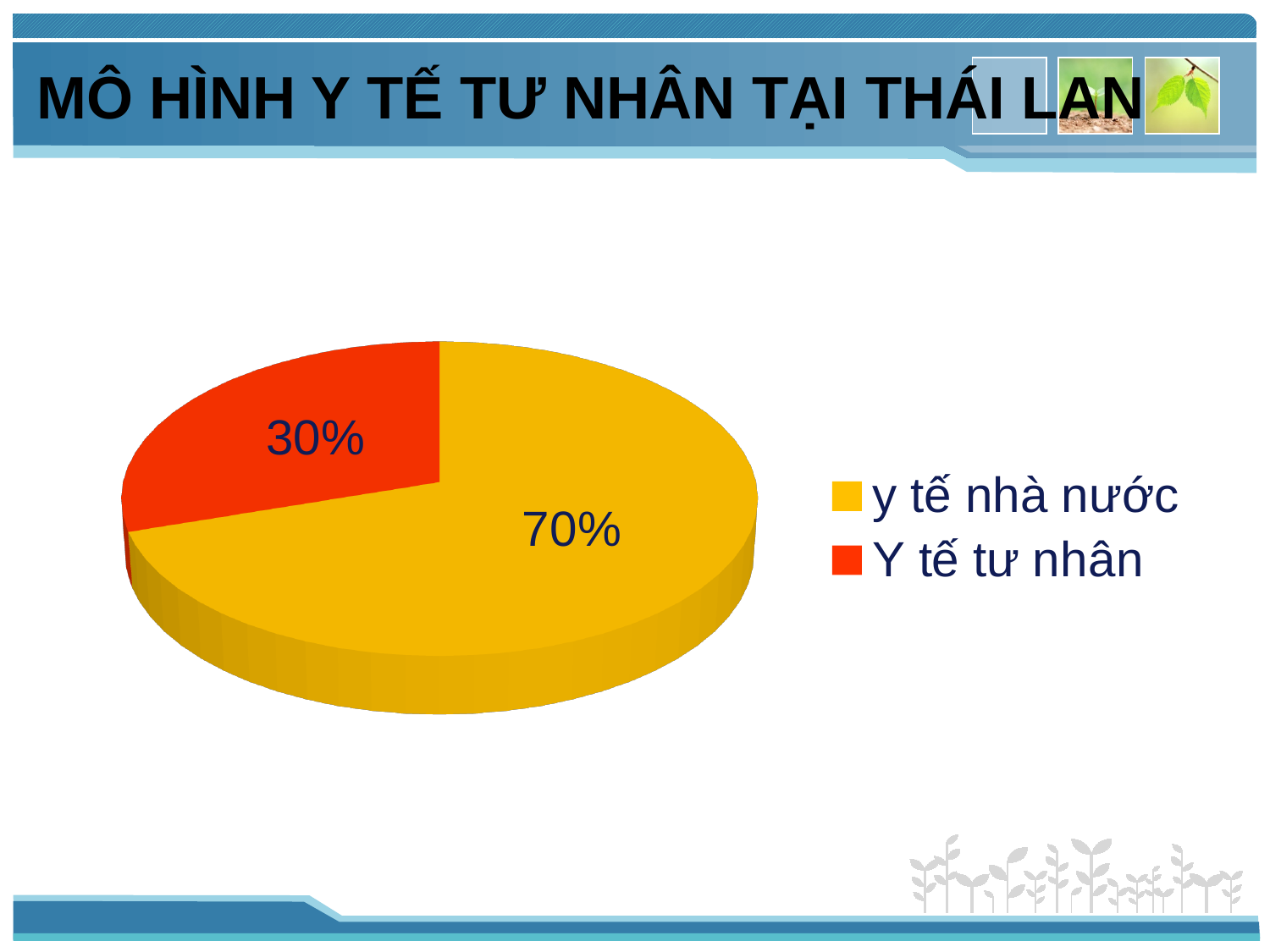
What is the difference between the shares of "y tế nhà nước" and "Y tế tư nhân"? 40% What share of the pie does "Y tế tư nhân" have? 30% What share of the pie does "y tế nhà nước" have? 70% What colour is the "y tế nhà nước" slice? yellow Which slice is the smallest? Y tế tư nhân Which slice is the largest? y tế nhà nước How many slices does the pie chart have? 2 How many entries does the legend list? 2 Which is larger, the share for "y tế nhà nước" or for "Y tế tư nhân"? y tế nhà nước What kind of chart is shown on the slide? pie chart What colour is the "Y tế tư nhân" slice? red